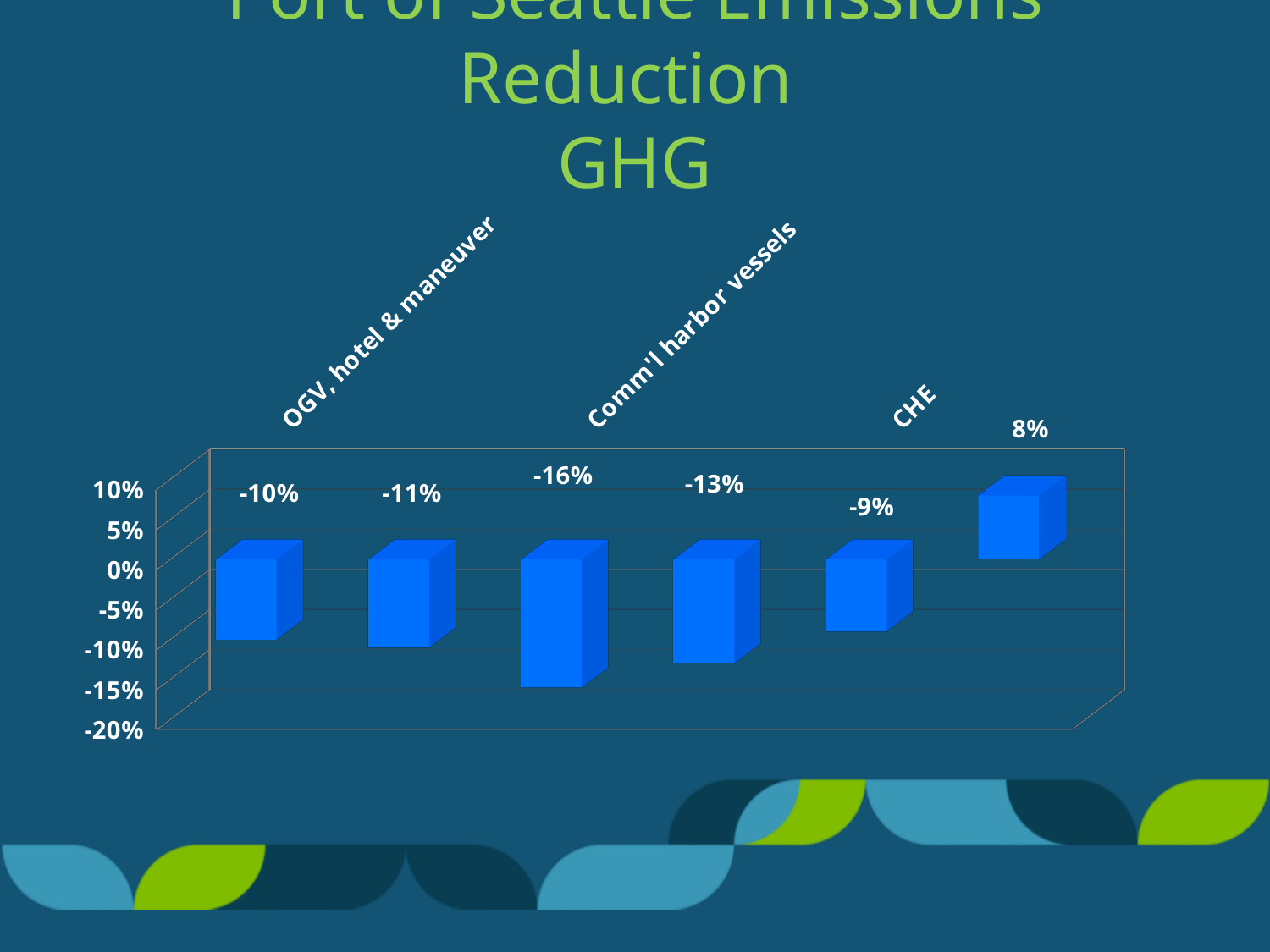
How many bars are plotted on the chart? 6 What is the value for OGV, hotel & maneuver? -10% What is the highest value shown on the chart? 8% Which labelled category has the lowest value? Comm'l harbor vessels What is the value for Comm'l harbor vessels? -16% Is the value for CHE greater or less than 0%? less How many bars have a positive value? 1 Which is larger, the value for OGV, hotel & maneuver or the value for CHE? CHE What is the difference between the values for OGV, hotel & maneuver and Comm'l harbor vessels? 6 percentage points What is the value for CHE? -9% What is the title of the slide? Port of Seattle Emissions Reduction GHG What kind of chart is shown on the slide? Bar chart